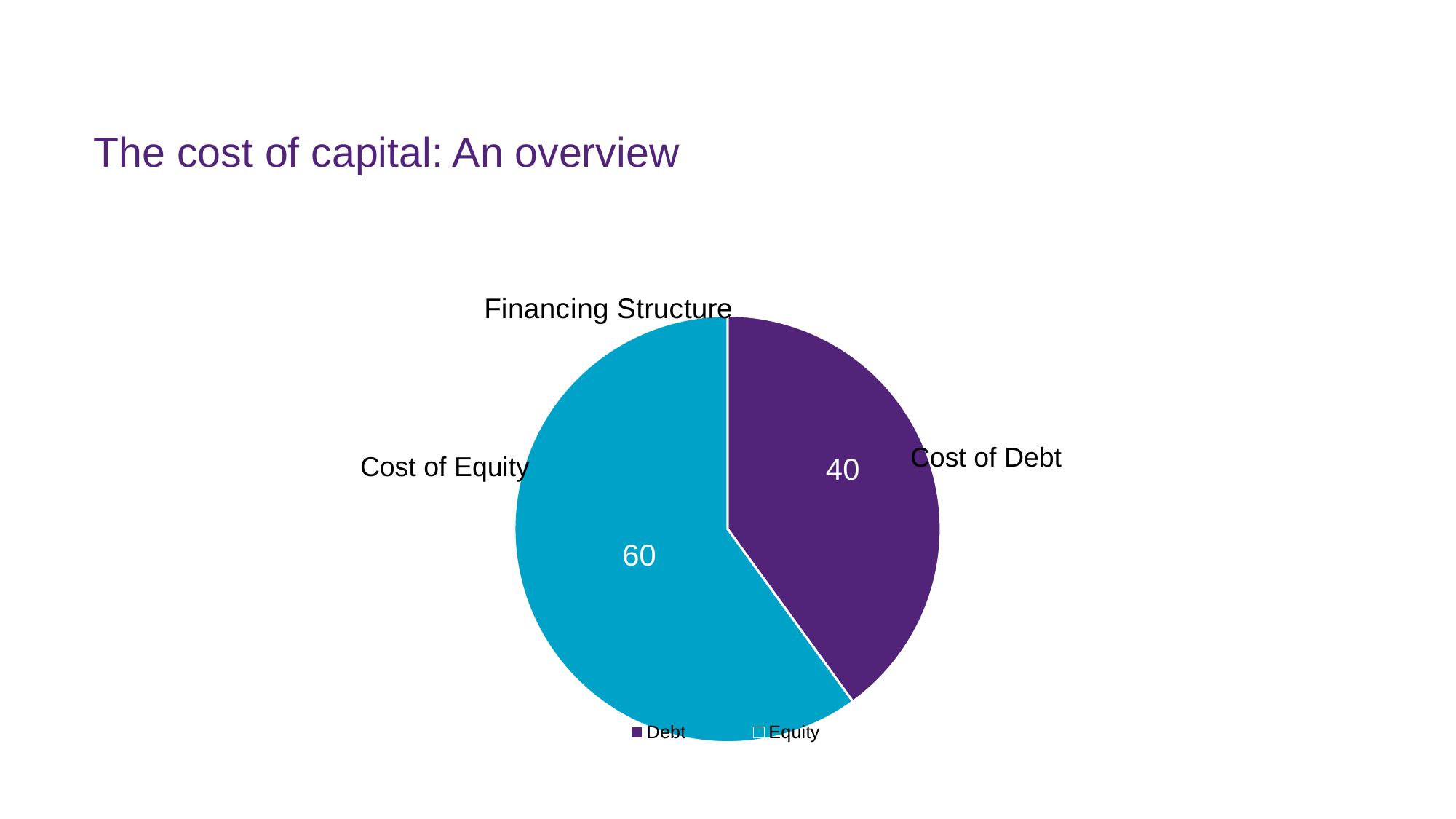
Which slice is the smallest? Debt How many entries does the legend list? 2 What colour is the Equity slice? blue How many slices does the pie chart have? 2 Which is larger, Debt or Equity? Equity What type of chart is shown on the slide? pie chart What is the title of the chart? Financing Structure Which slice is the largest? Equity What is the difference between the Equity and Debt values? 20 What share of the pie does the Debt slice represent? 40% What is the value of the Equity slice? 60 What is the value of the Debt slice? 40